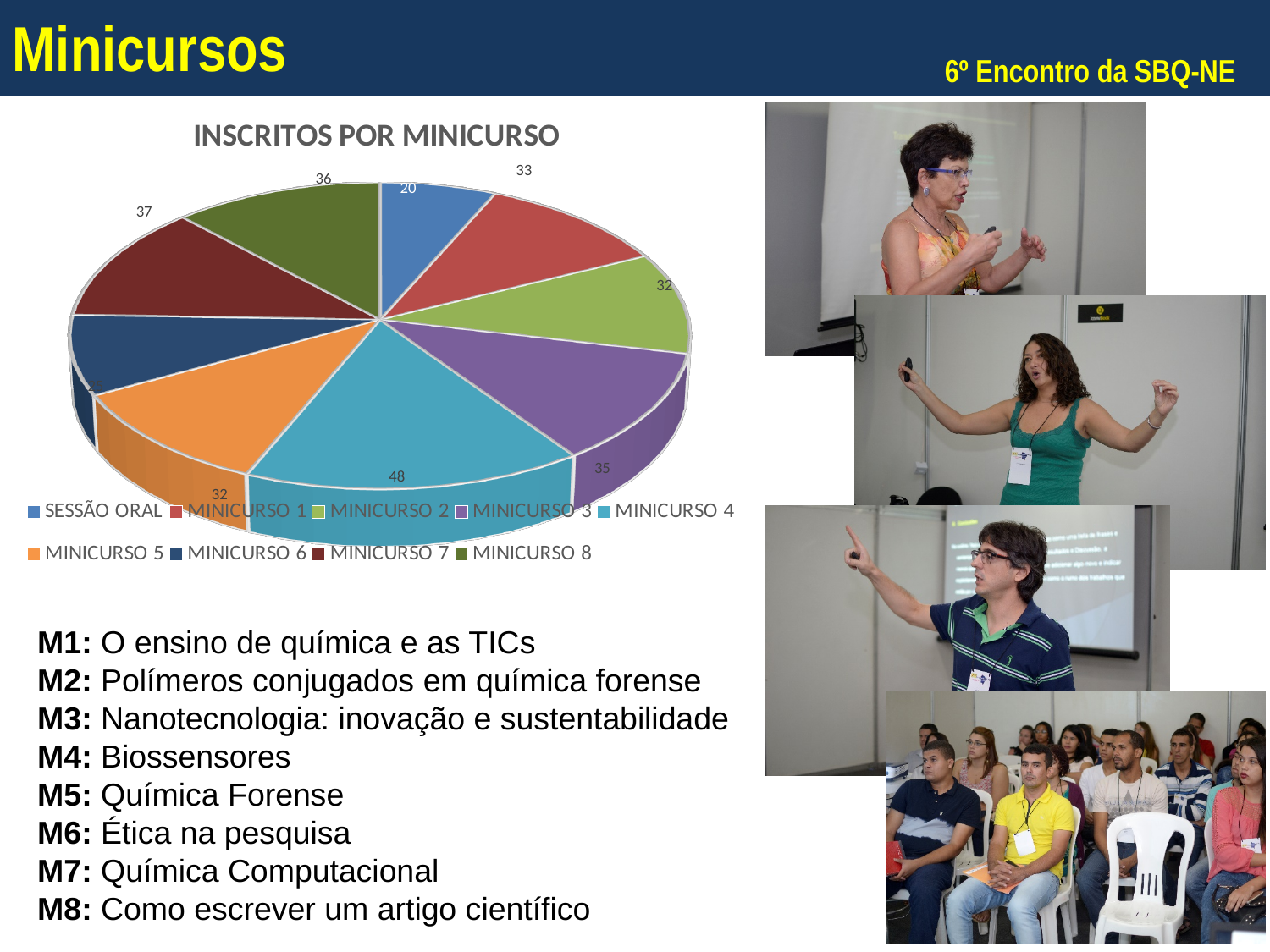
What value is shown for MINICURSO 7? 37 What is the difference between the values for MINICURSO 4 and MINICURSO 3? 13 What kind of chart is shown on the slide? Pie chart What value is shown for MINICURSO 3? 35 Which category has the largest slice in the pie chart? MINICURSO 4 How many registrants does the chart show for MINICURSO 4? 48 What is the title of the chart? INSCRITOS POR MINICURSO What value is shown for MINICURSO 1? 33 What value is shown for SESSÃO ORAL? 20 Which has a higher value, MINICURSO 7 or MINICURSO 8? MINICURSO 7 What value is shown for MINICURSO 8? 36 How many entries does the chart legend list? 9